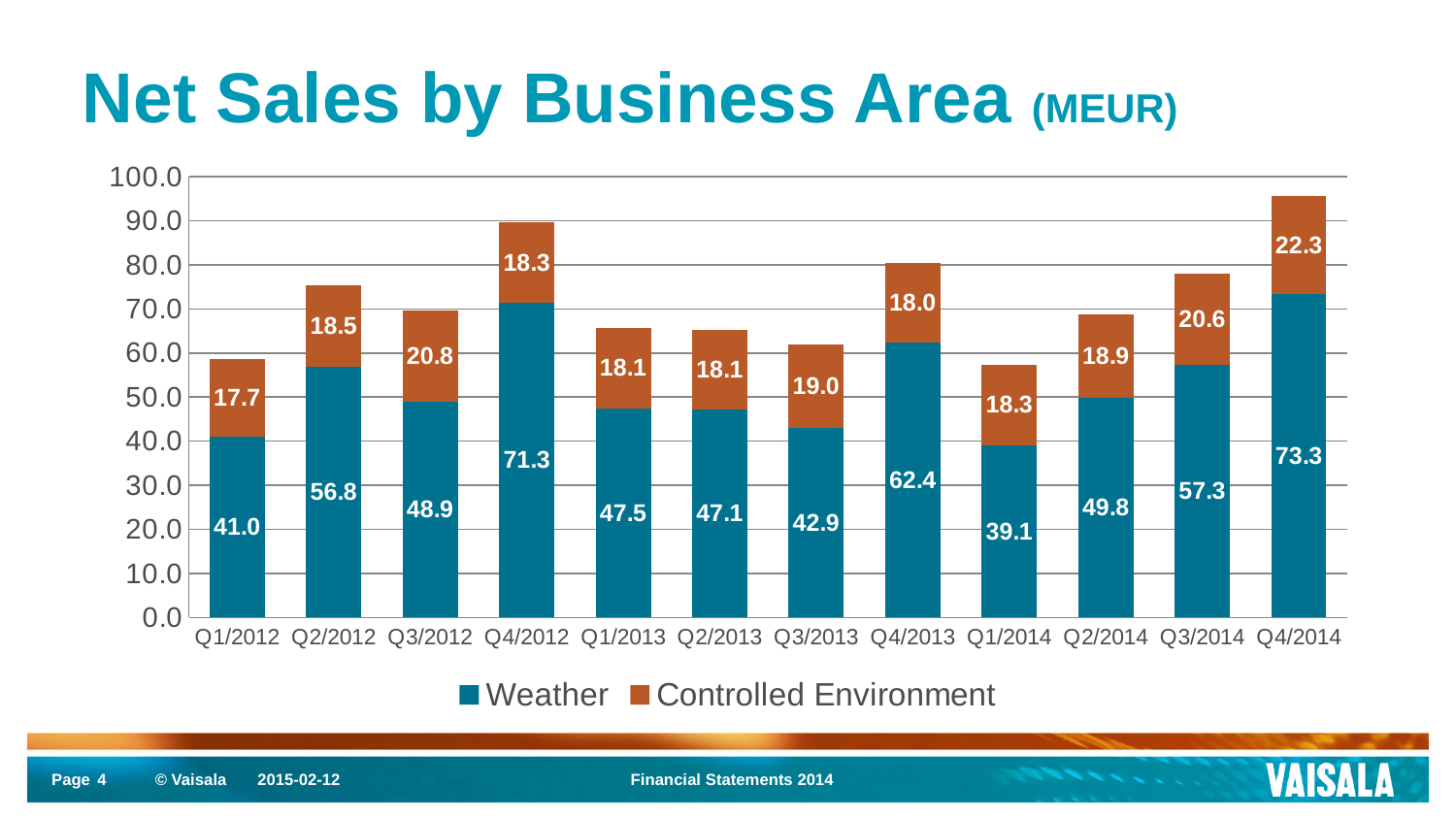
Is the Weather value for Q4/2013 larger than the Weather value for Q2/2012? Yes Which quarter has the lowest Weather value? Q1/2014 What is the total net sales for Q4/2014 (Weather plus Controlled Environment)? 95.6 What is the title of the chart? Net Sales by Business Area (MEUR) How many quarters are shown on the x axis? 12 Which quarter has the highest Controlled Environment value? Q4/2014 What is the Controlled Environment value for Q3/2012? 20.8 What is the Weather net sales value for Q4/2014? 73.3 Which quarter has the highest Weather value? Q4/2014 What is the difference between the Weather values for Q4/2012 and Q1/2012? 30.3 What kind of chart is shown on the slide? Stacked bar chart How many series does the legend list? 2